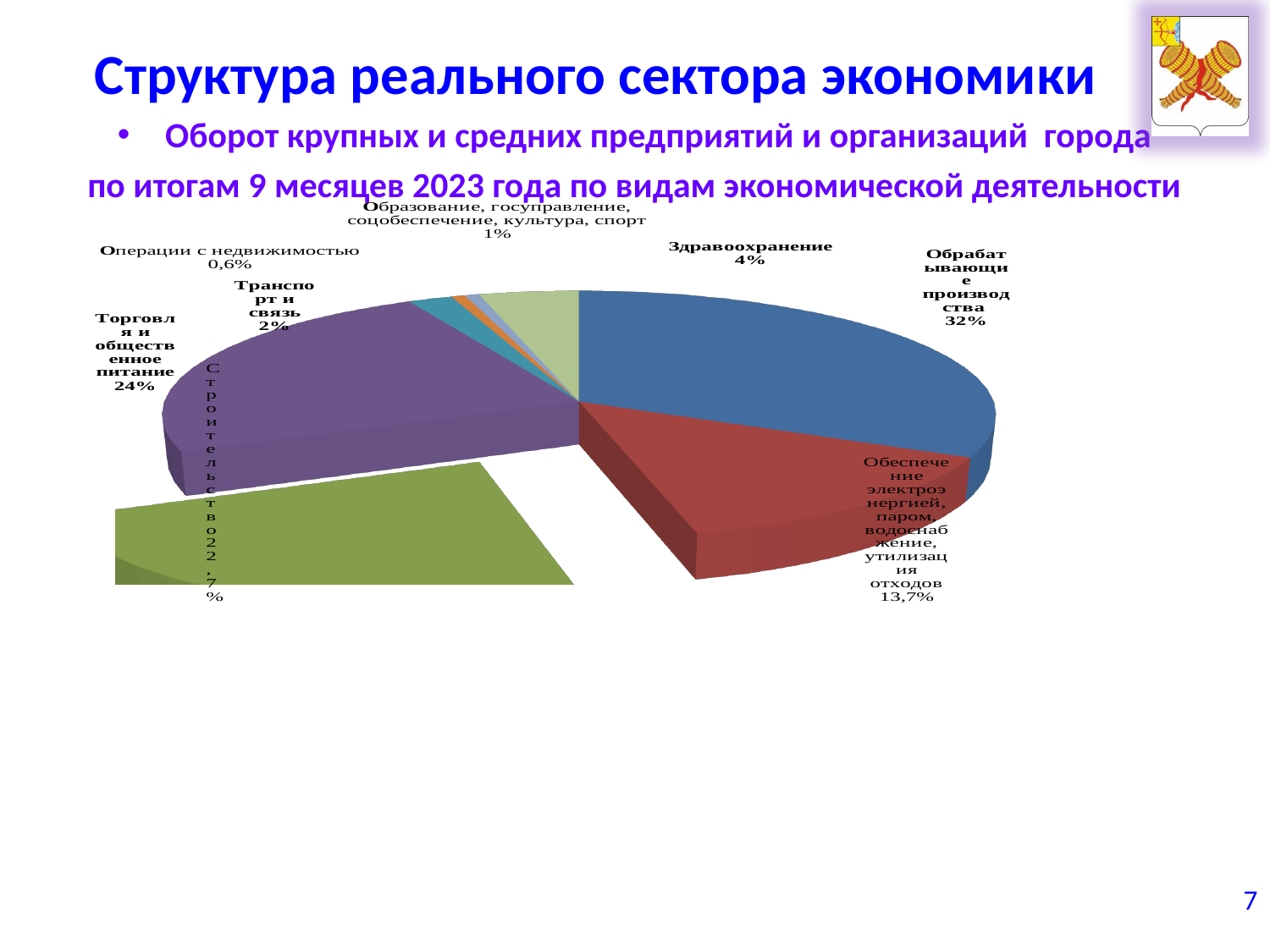
What share of the pie does "Обеспечение электроэнергией, паром, водоснабжение, утилизация отходов" have? 13,7% How many slices does the pie chart have? 8 Which is larger: the share for "Транспорт и связь" or the share for "Здравоохранение"? Здравоохранение What share of the pie does "Здравоохранение" have? 4% Which category has the smallest share of the pie? Операции с недвижимостью What share of the pie does "Операции с недвижимостью" have? 0,6% Which category has the largest share of the pie? Обрабатывающие производства What kind of chart is shown on the slide? pie chart What share of the pie does "Торговля и общественное питание" have? 24% What share of the pie does "Обрабатывающие производства" have? 32% What share of the pie does "Строительство" have? 22,7% What is the difference in percentage points between "Обрабатывающие производства" and "Торговля и общественное питание"? 8